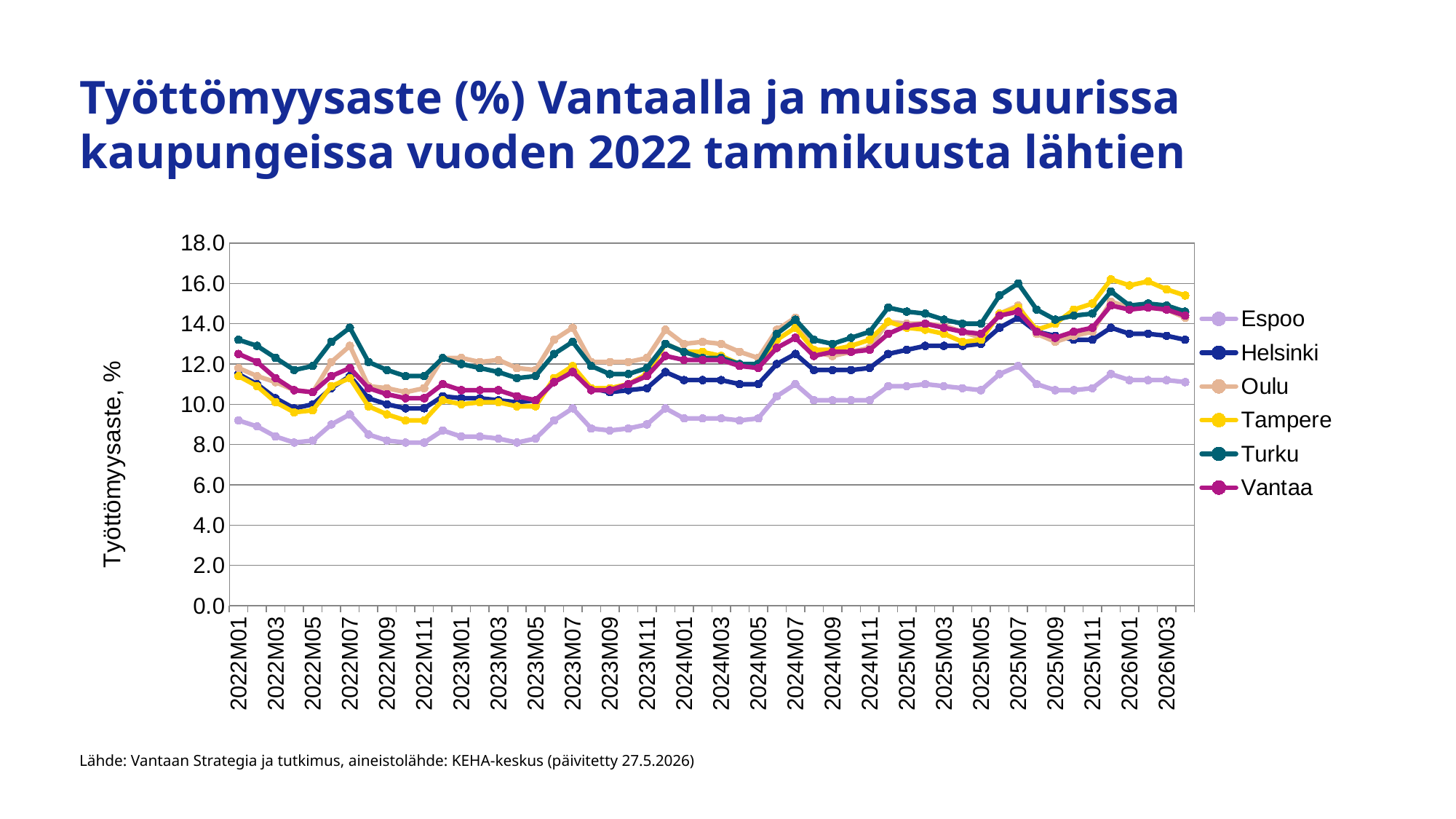
Which city is listed last in the legend? Vantaa What kind of chart is shown on the slide? line chart Is the value for Espoo at 2022M01 greater or less than 10.0? less Is the value for Vantaa at 2026M01 greater or less than 14.0? greater Does the unemployment rate for Espoo generally rise or fall from 2022M01 to the end of the series? rise Is the value for Turku at 2025M07 greater or less than 14.0? greater At 2022M01, which is larger, the value for Turku or the value for Espoo? Turku Which city has the lowest unemployment rate at 2022M01? Espoo Which city has the highest unemployment rate at 2025M07? Turku How many series does the legend list? 6 What is the label of the vertical axis? Työttömyysaste, %